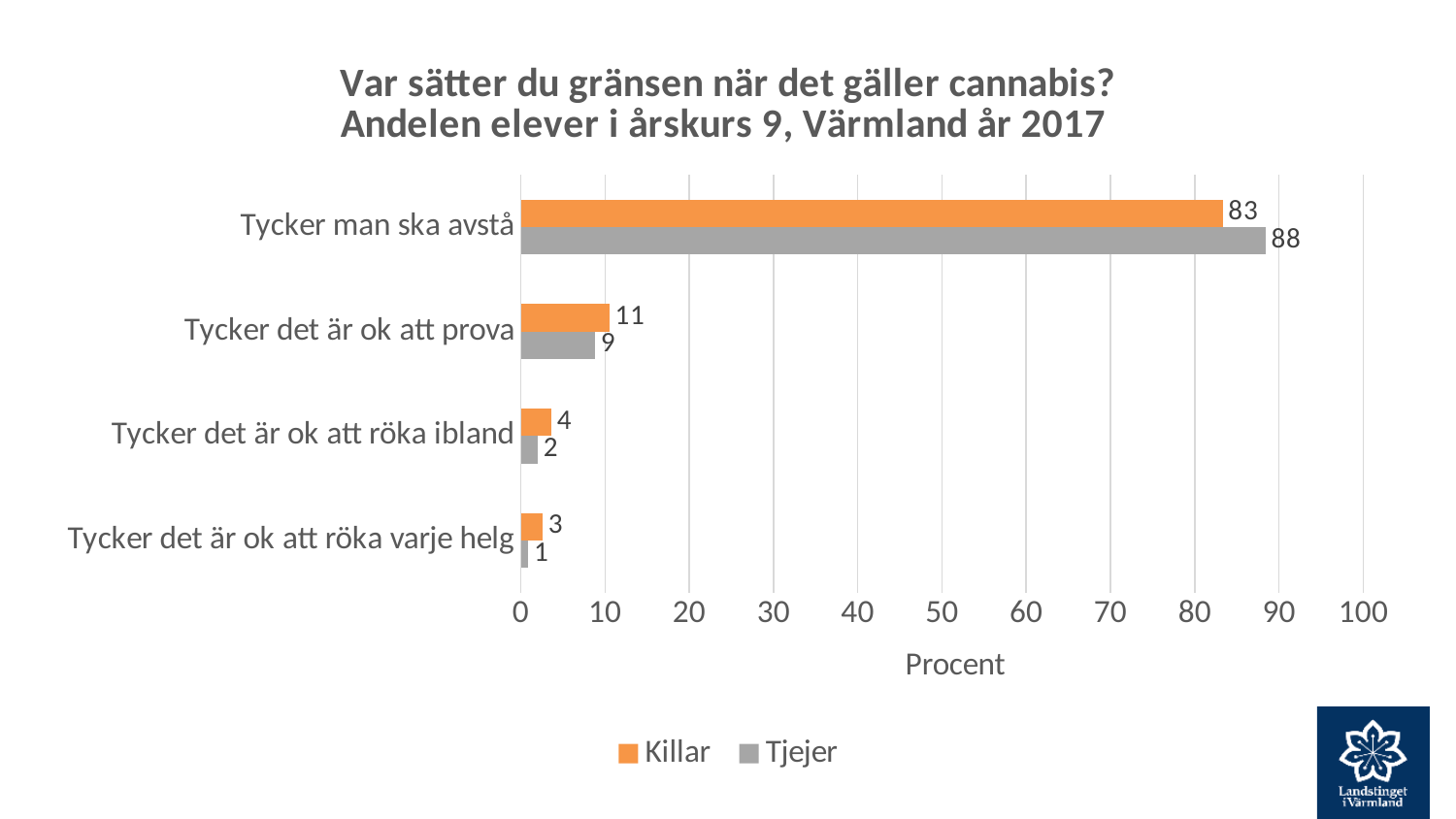
How many categories are shown on the chart? 4 What is the value for Killar in the category "Tycker det är ok att röka varje helg"? 3 Which category has the lowest value for Killar? Tycker det är ok att röka varje helg What is the label of the horizontal axis? Procent Which category has the highest value for Tjejer? Tycker man ska avstå What kind of chart is shown on the slide? Bar chart How many series does the legend list? 2 What is the value for Tjejer in the category "Tycker man ska avstå"? 88 What is the value for Tjejer in the category "Tycker det är ok att prova"? 9 What is the difference between the Tjejer and Killar values for "Tycker man ska avstå"? 5 What is the value for Killar in the category "Tycker man ska avstå"? 83 Which is larger for "Tycker det är ok att prova": the Killar value or the Tjejer value? Killar